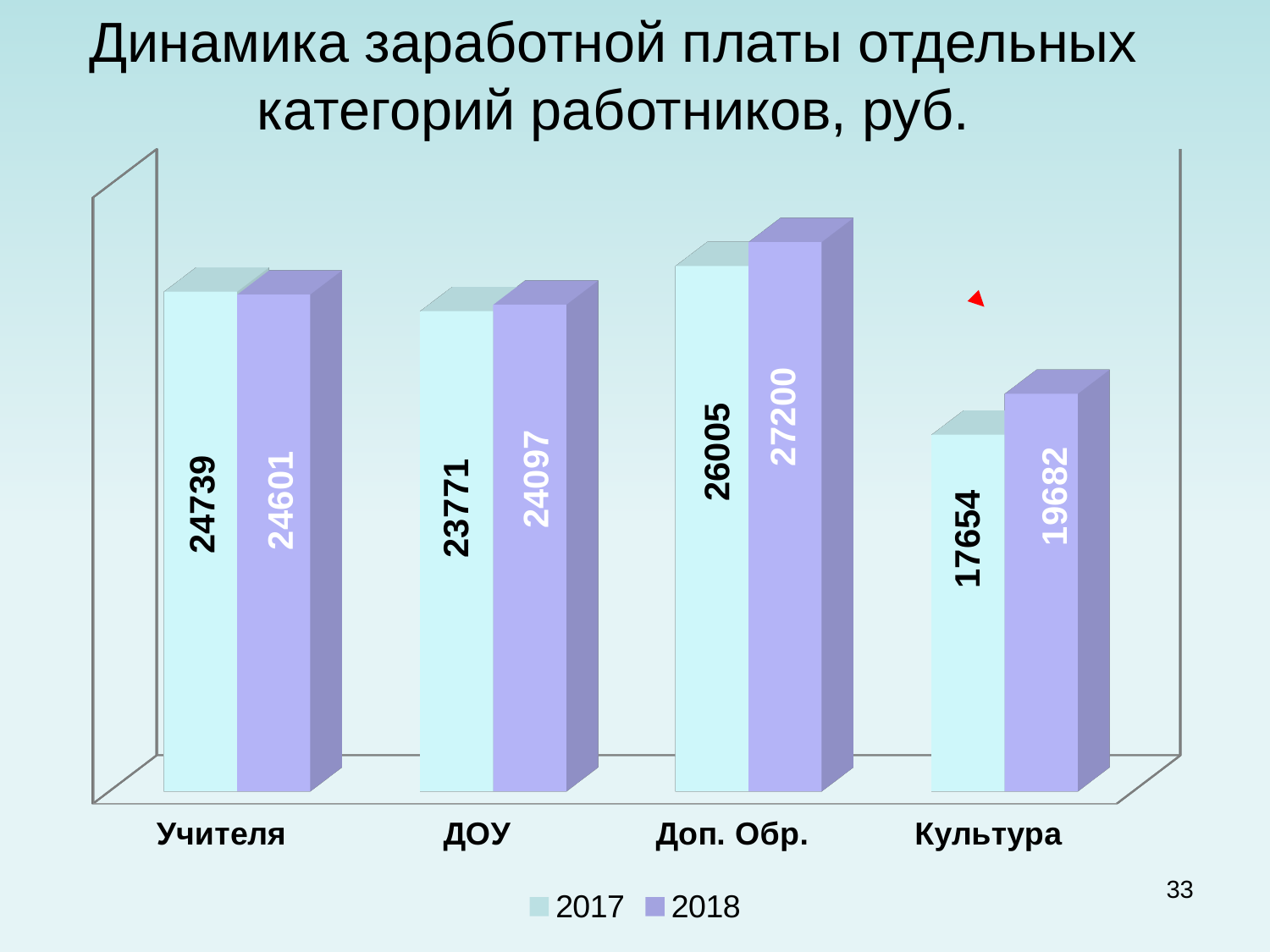
Which is larger for Доп. Обр., the 2017 value or the 2018 value? 2018 Which category has the lowest 2017 value? Культура What is the 2017 value for Учителя? 24739 What is the 2018 value for Доп. Обр.? 27200 How many series does the legend list? 2 What is the difference between the 2018 and 2017 values for Культура? 2028 What is the difference between the 2017 and 2018 values for Учителя? 138 Which category has the highest 2018 value? Доп. Обр. How many categories are shown on the x axis? 4 What is the 2018 value for ДОУ? 24097 What kind of chart is shown on the slide? bar chart What is the 2017 value for Культура? 17654